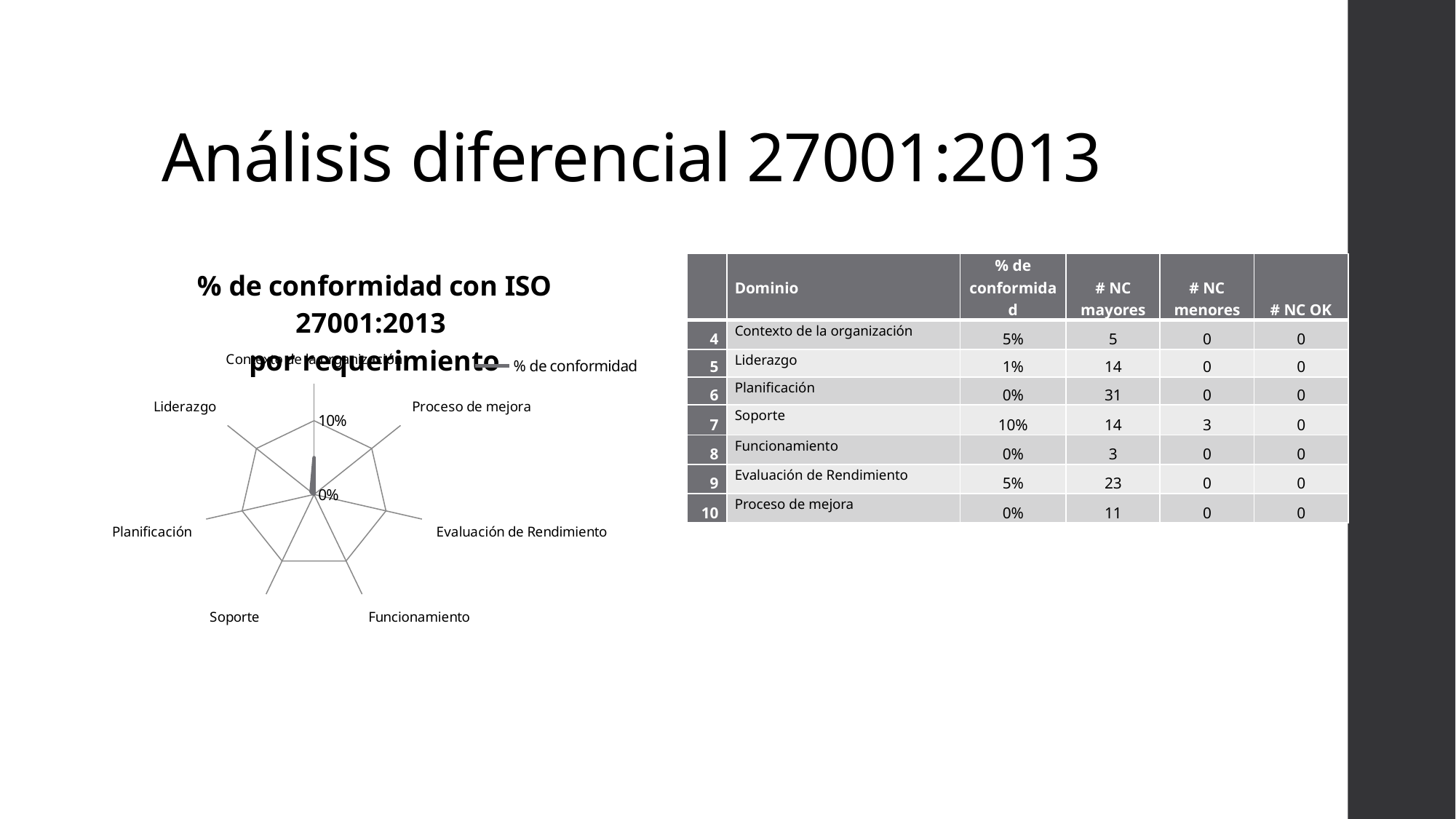
What kind of chart is shown on the slide? Radar chart How many categories (axes) does the radar chart have? 7 Is the value for Planificación in the radar chart greater or less than 10%? less Is the value for Proceso de mejora in the radar chart greater or less than 10%? less Is the value for Evaluación de Rendimiento in the radar chart greater or less than 10%? less What is the title of the radar chart? % de conformidad con ISO 27001:2013 por requerimiento How many series does the legend of the radar chart list? 1 What is the highest axis tick label shown on the radar chart? 10% What series name appears in the legend of the radar chart? % de conformidad